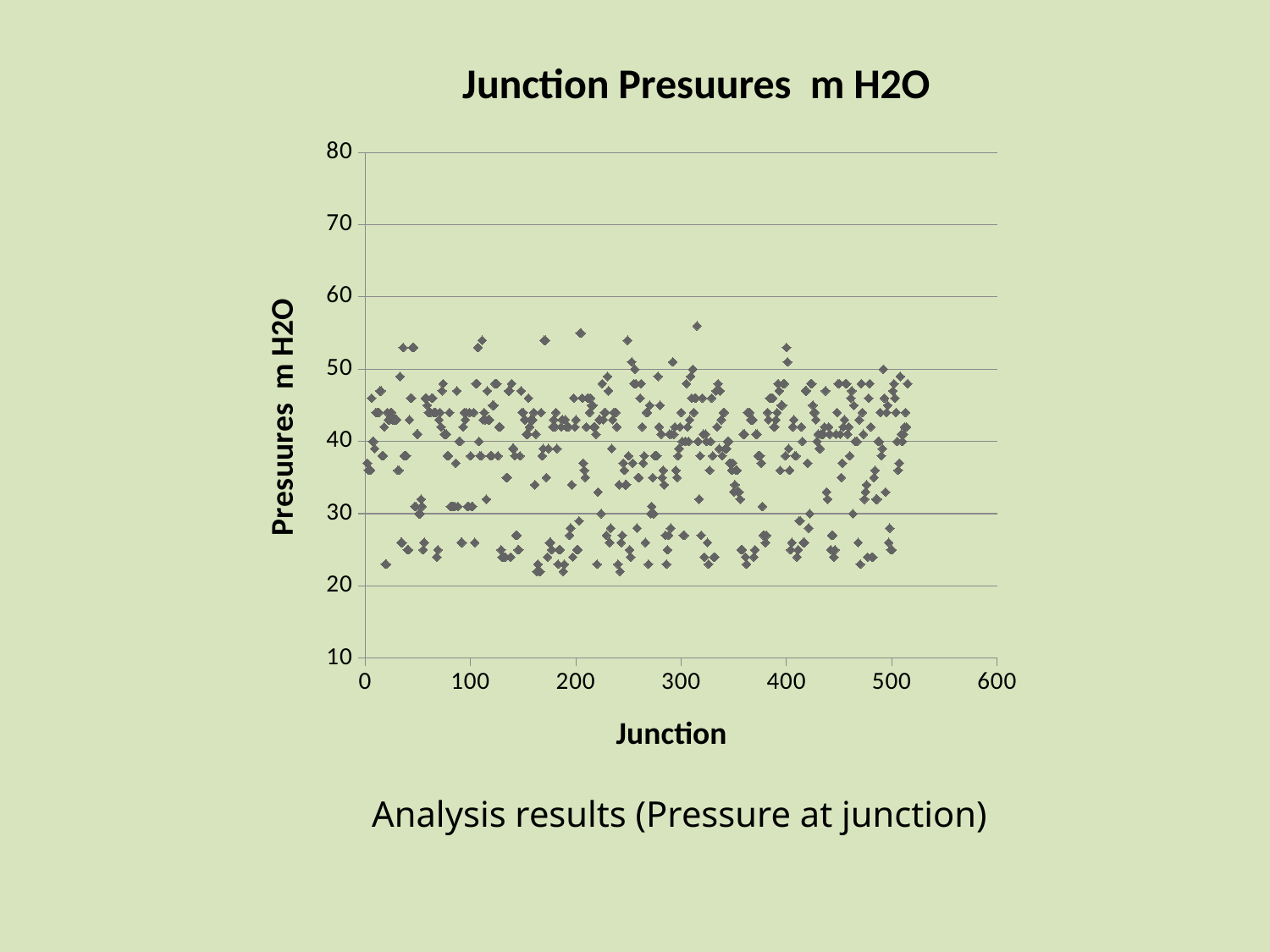
What is the title of the chart? Junction Presuures m H2O Is the largest junction number plotted on the x axis greater or less than 600? less Is the highest plotted pressure value greater or less than 60? less Is the lowest plotted pressure value greater or less than 30? less What is the label on the horizontal axis of the chart? Junction What kind of chart is shown on the slide? scatter chart Do the plotted pressure values show a clear rising or falling trend as the junction number increases? No clear trend